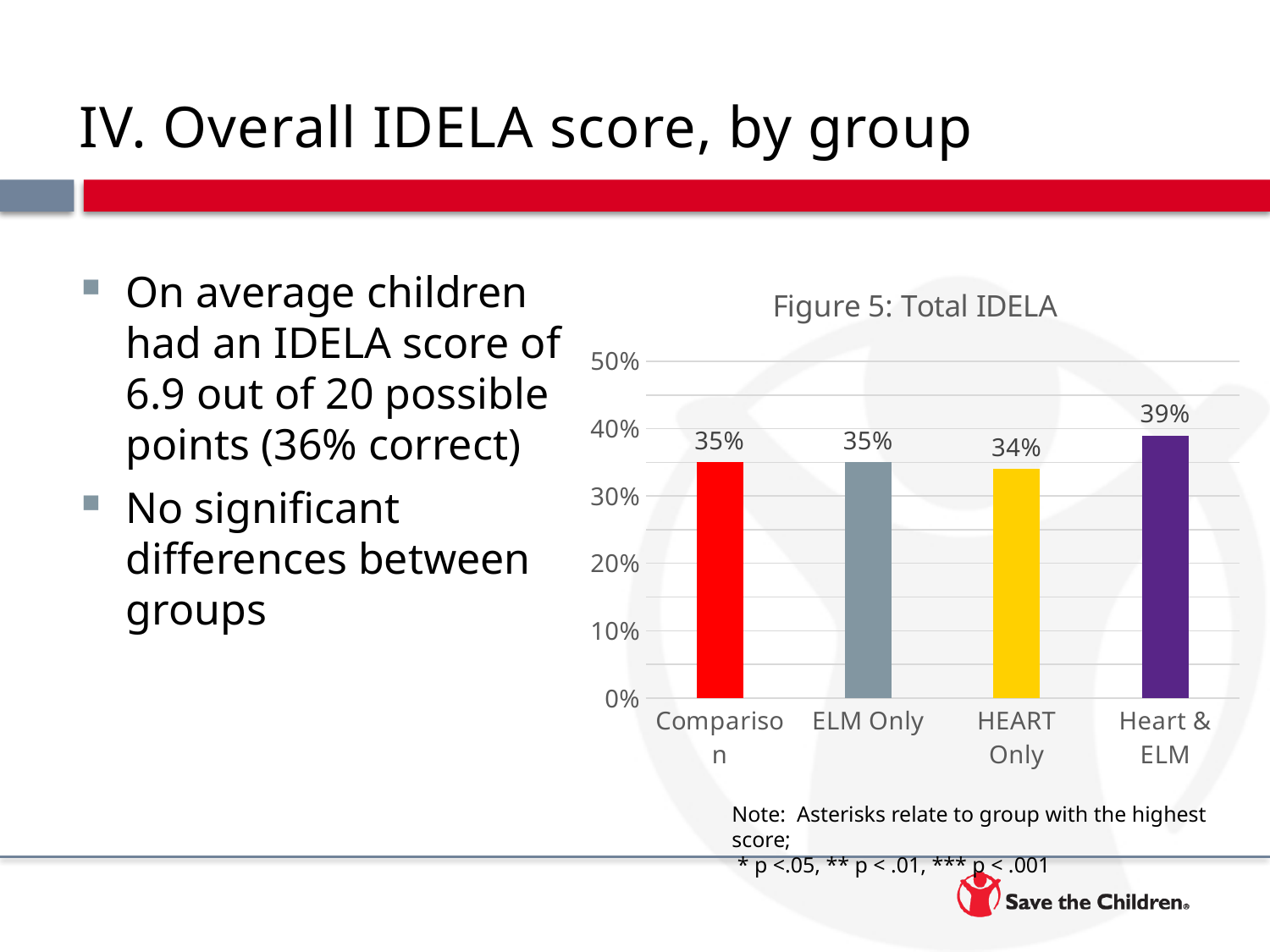
Which group has the highest Total IDELA score in the chart? Heart & ELM What is the difference between the Heart & ELM value and the Comparison value? 4% How many groups are shown on the x axis of the chart? 4 What is the value for Comparison in the Figure 5: Total IDELA chart? 35% Which is larger, the value for Heart & ELM or the value for ELM Only? Heart & ELM What is the difference between the Heart & ELM value and the HEART Only value? 5% What kind of chart is Figure 5: Total IDELA? Bar chart What is the value for ELM Only in the Figure 5: Total IDELA chart? 35% What is the title of the chart on the slide? Figure 5: Total IDELA What is the value for Heart & ELM in the Figure 5: Total IDELA chart? 39% Which group has the lowest Total IDELA score in the chart? HEART Only What is the value for HEART Only in the Figure 5: Total IDELA chart? 34%